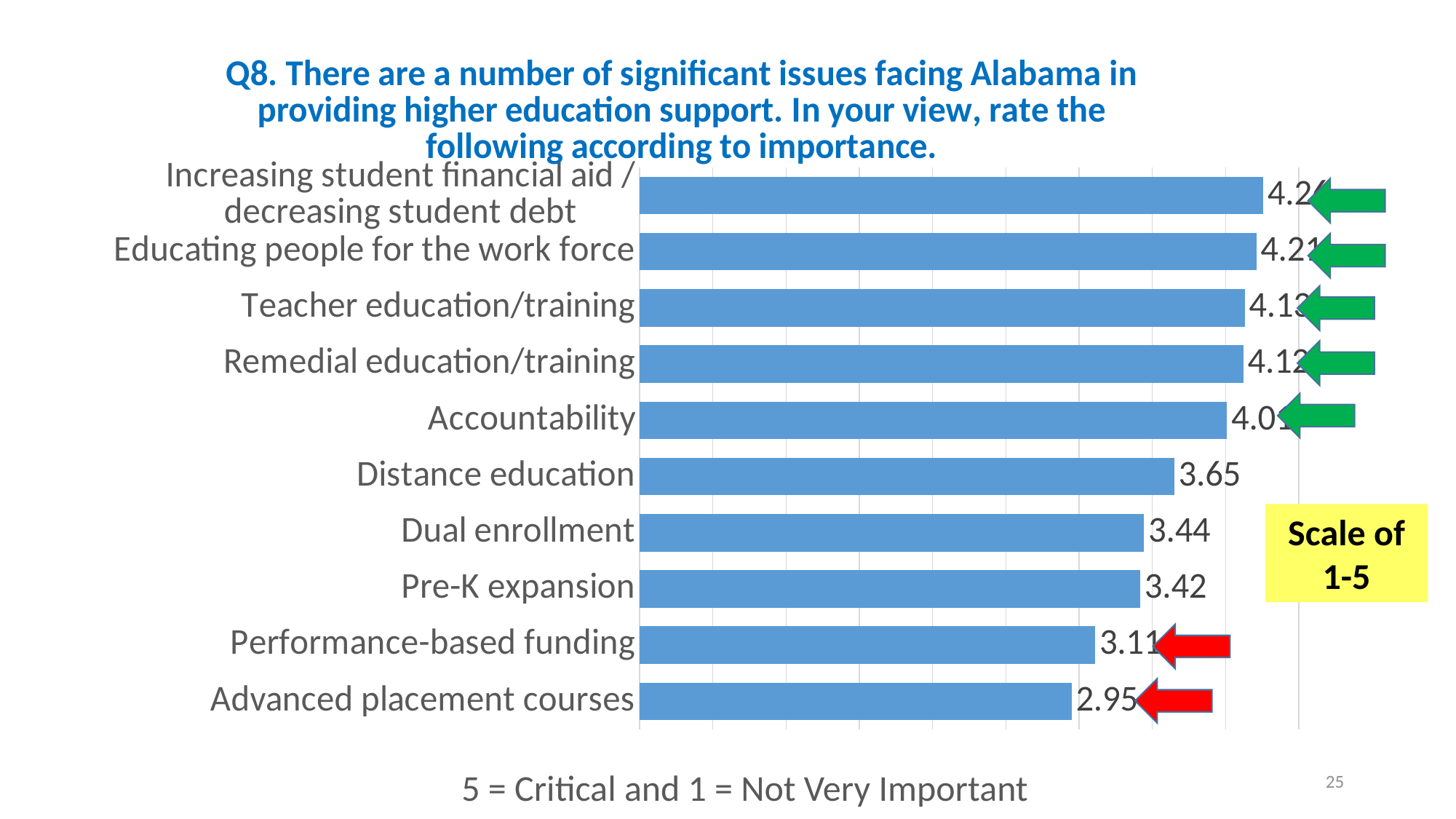
What rating scale does the chart use, according to the yellow box? Scale of 1-5 Which category has the lowest value? Advanced placement courses How many categories are shown in the chart? 10 What is the difference between the values for Distance education and Advanced placement courses? 0.70 Which has a larger value, Pre-K expansion or Advanced placement courses? Pre-K expansion What kind of chart is shown on the slide? Bar chart Which has a larger value, Distance education or Dual enrollment? Distance education What is the value for Pre-K expansion? 3.42 What is the difference between the values for Dual enrollment and Pre-K expansion? 0.02 What is the value for Dual enrollment? 3.44 What is the value for Distance education? 3.65 What is the value for Advanced placement courses? 2.95